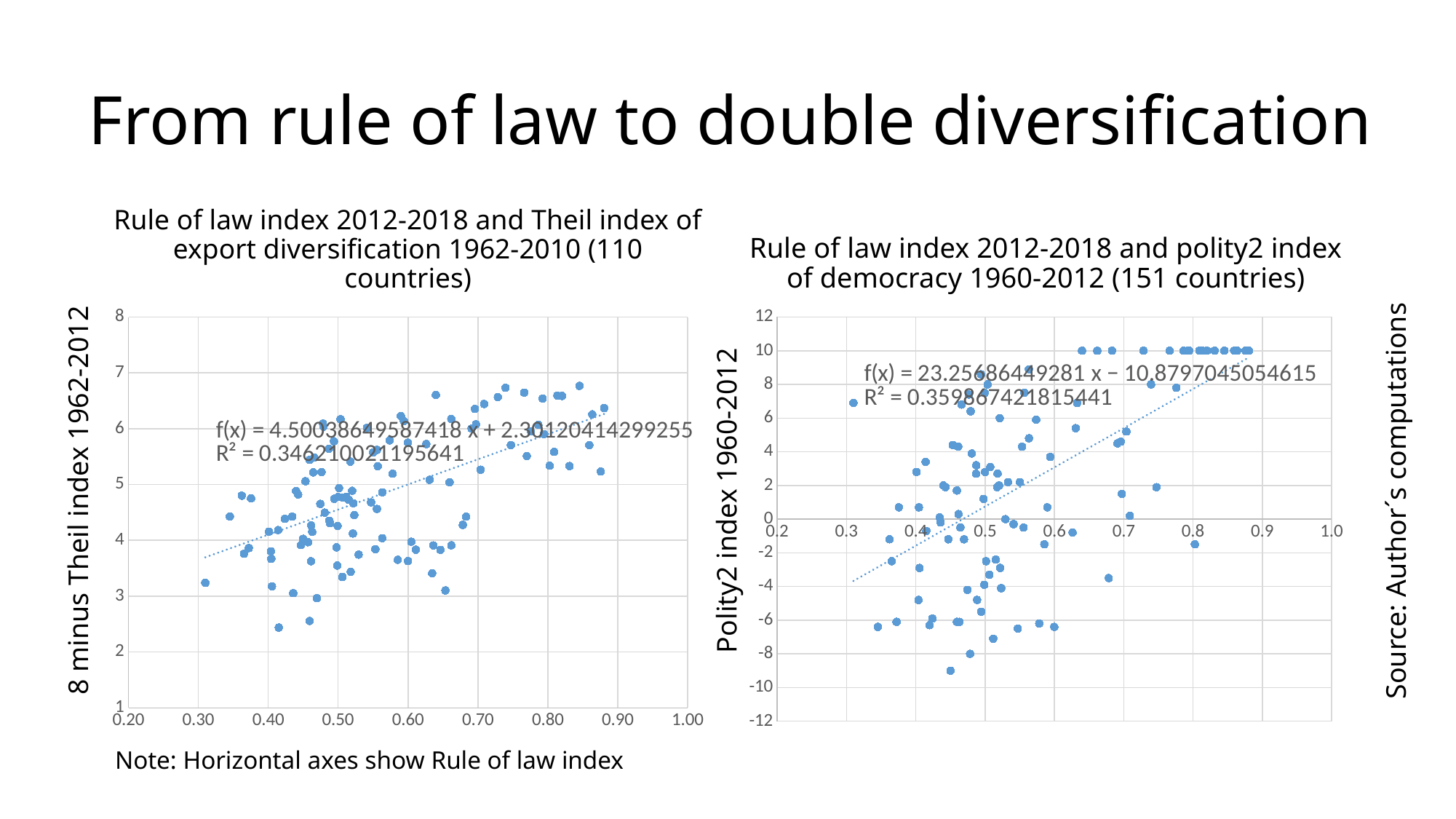
In the left chart (Rule of law index and Theil index of export diversification), do the values generally rise or fall as the rule of law index increases? Rise In the left chart (Rule of law index and Theil index of export diversification), what is the fitted trend line equation shown? f(x) = 4.50038649587418 x + 2.30120414299255 In the left chart (Rule of law index and Theil index of export diversification), what is the R² value shown? 0.346210021195641 In the right chart (Rule of law index and polity2 index of democracy), what is the R² value shown? 0.359867421815441 According to its title, how many countries are plotted in the right chart? 151 In the right chart (Rule of law index and polity2 index of democracy), do the values generally rise or fall as the rule of law index increases? Rise In the right chart (Rule of law index and polity2 index of democracy), what is the fitted trend line equation shown? f(x) = 23.25686449281 x − 10.8797045054615 According to its title, how many countries are plotted in the left chart? 110 What kind of chart is the right chart on the slide? Scatter chart In the right chart (Rule of law index and polity2 index of democracy), what is the highest Polity2 index value reached by the plotted points? 10 What is the label of the vertical axis of the left chart? 8 minus Theil index 1962-2012 What kind of chart is the left chart on the slide? Scatter chart